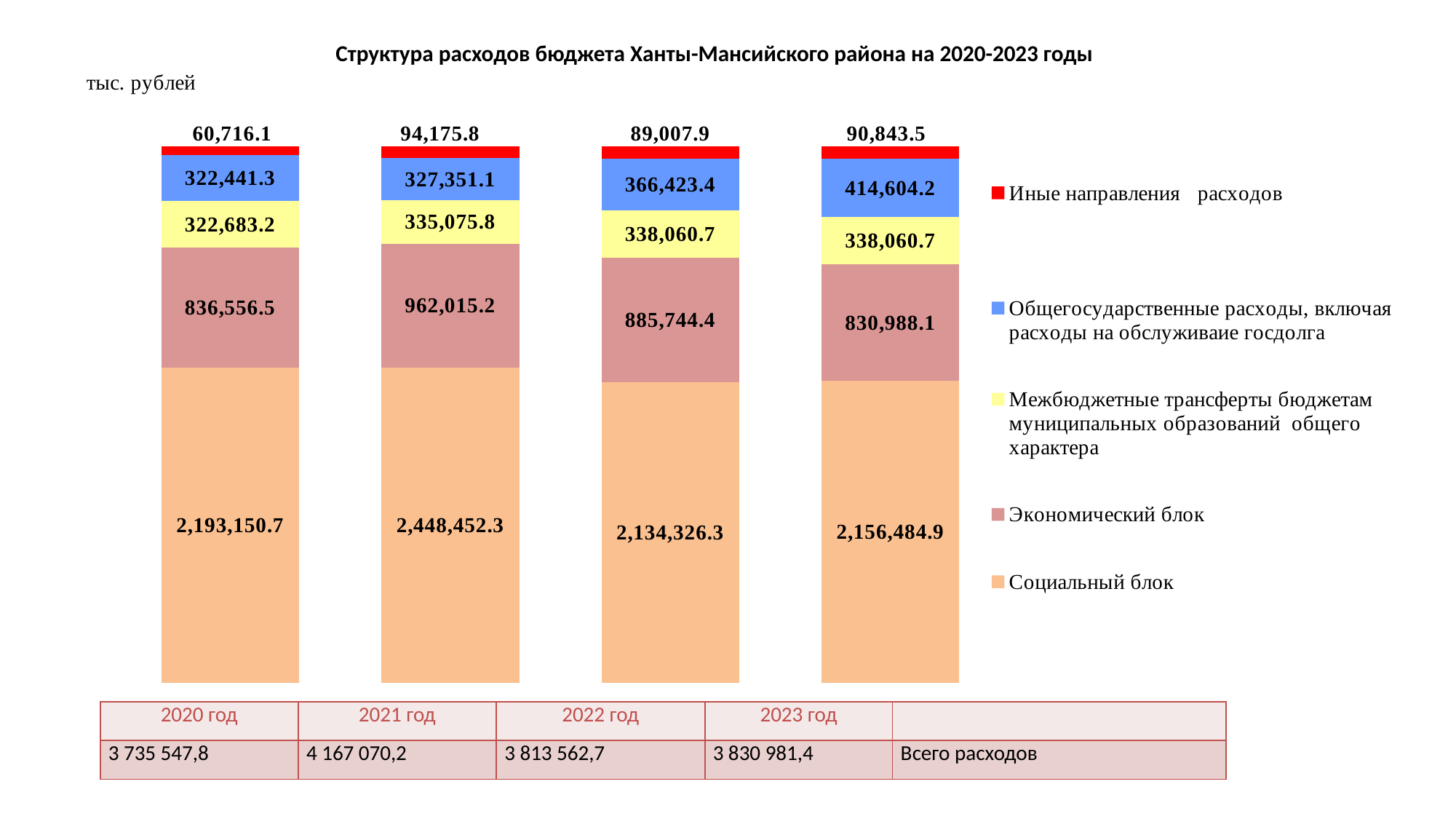
What is the value of Экономический блок for 2022 год? 885,744.4 What is the value of Межбюджетные трансферты бюджетам муниципальных образований общего характера for 2021 год? 335,075.8 In which year is Социальный блок the highest? 2021 год How many series does the legend list? 5 What is the value of Иные направления расходов for 2020 год? 60,716.1 Which is larger, Экономический блок in 2020 год or in 2023 год? 2020 год What is the difference between Общегосударственные расходы in 2023 год and 2022 год? 48,180.8 Does Общегосударственные расходы rise or fall from 2020 год to 2023 год? Rise What is the value of Социальный блок for 2021 год? 2,448,452.3 In which year is Иные направления расходов the lowest? 2020 год How many years (bars) are shown in the chart? 4 What kind of chart is shown on the slide? Stacked bar chart